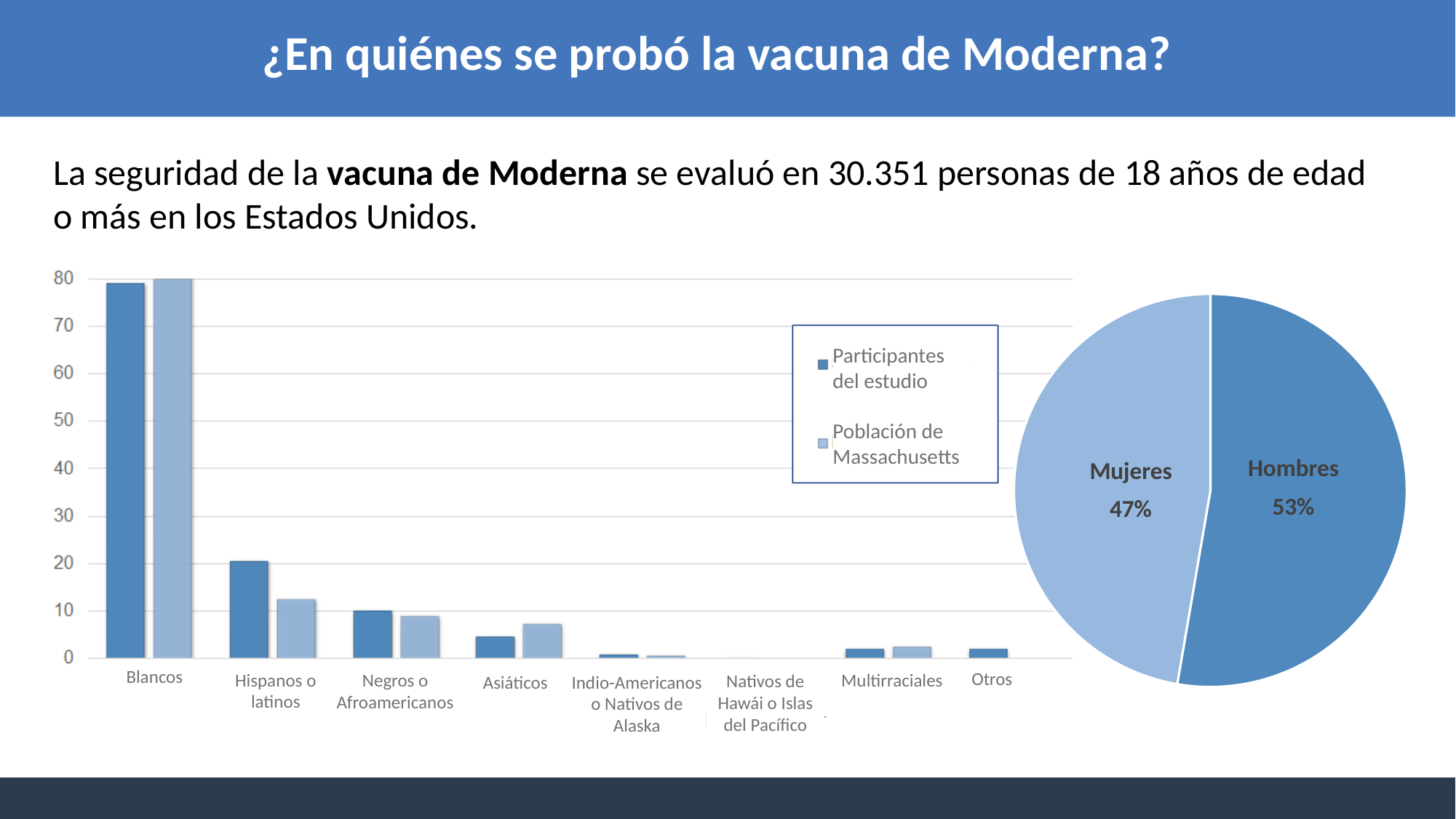
In the pie chart on the right, what is the difference between the Hombres and Mujeres shares? 6% How many categories are shown on the x axis of the bar chart on the left? 8 In the bar chart on the left, is the value for Hispanos o latinos in the Participantes del estudio series greater or less than 30? less What kind of chart is the chart on the left of the slide? bar chart In the pie chart on the right, what share is labelled for Mujeres? 47% In the pie chart on the right, which slice is larger, Mujeres or Hombres? Hombres In the pie chart on the right, what share is labelled for Hombres? 53% What kind of chart is the chart on the right of the slide? pie chart How many series does the legend of the bar chart on the left list? 2 In the bar chart on the left, which category has the highest value for Participantes del estudio? Blancos In the bar chart on the left, which series is shown in the darker blue colour? Participantes del estudio In the bar chart on the left, is the value for Blancos in the Participantes del estudio series greater or less than 70? greater